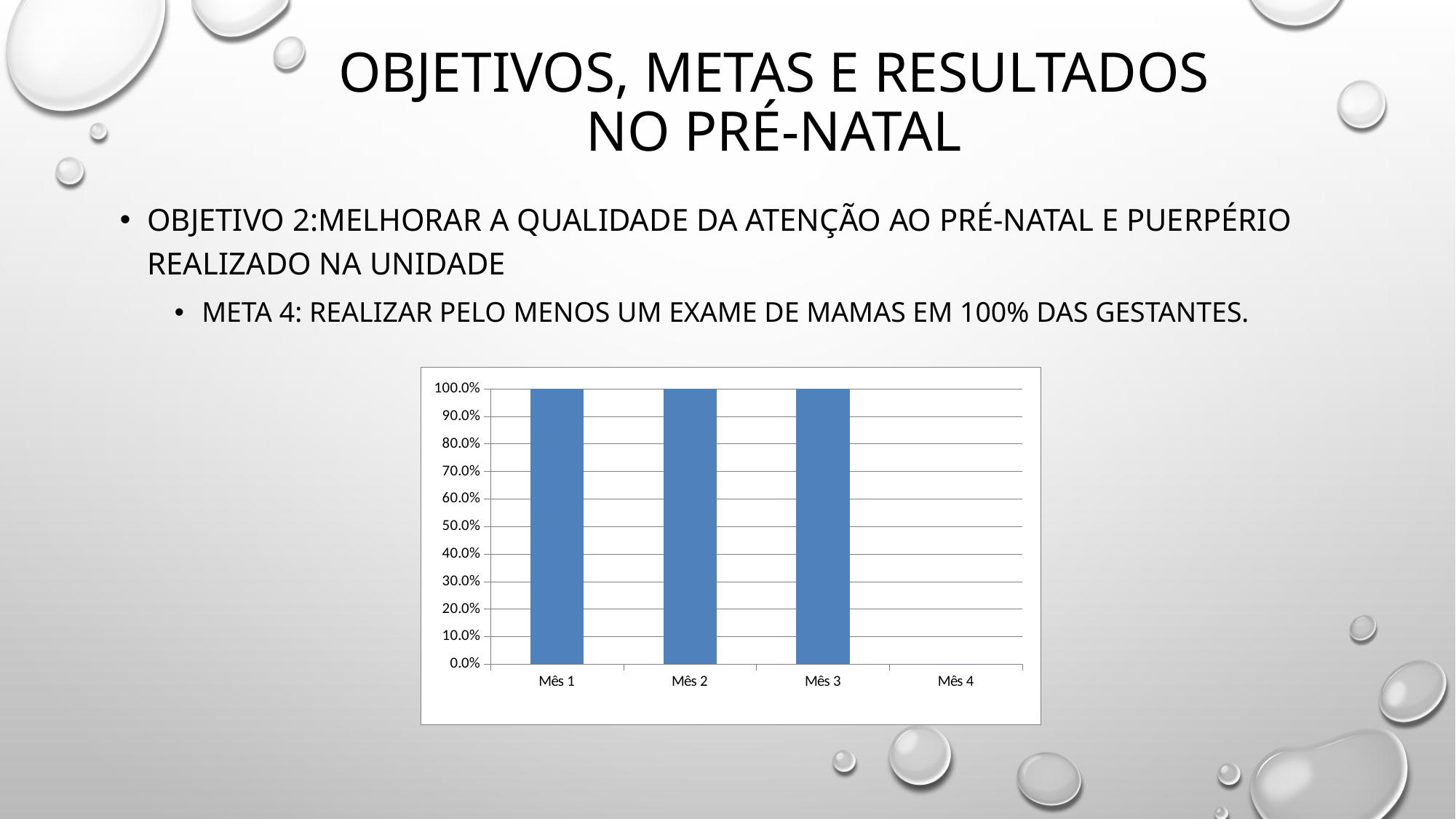
What is the value for Mês 1 in the chart? 100.0% Is the value for Mês 1 greater or less than 50.0%? greater What colour are the bars in the chart? blue What kind of chart is shown on the slide? bar chart Is the value for Mês 3 greater or less than 90.0%? greater Which category has the lowest value in the chart? Mês 4 How many categories are shown on the x axis of the chart? 4 What is the value for Mês 2 in the chart? 100.0% What is the difference between the values for Mês 1 and Mês 3? 0.0% What is the value for Mês 3 in the chart? 100.0% How many bars are visible in the chart? 3 Which is larger, the value for Mês 2 or the value for Mês 4? Mês 2